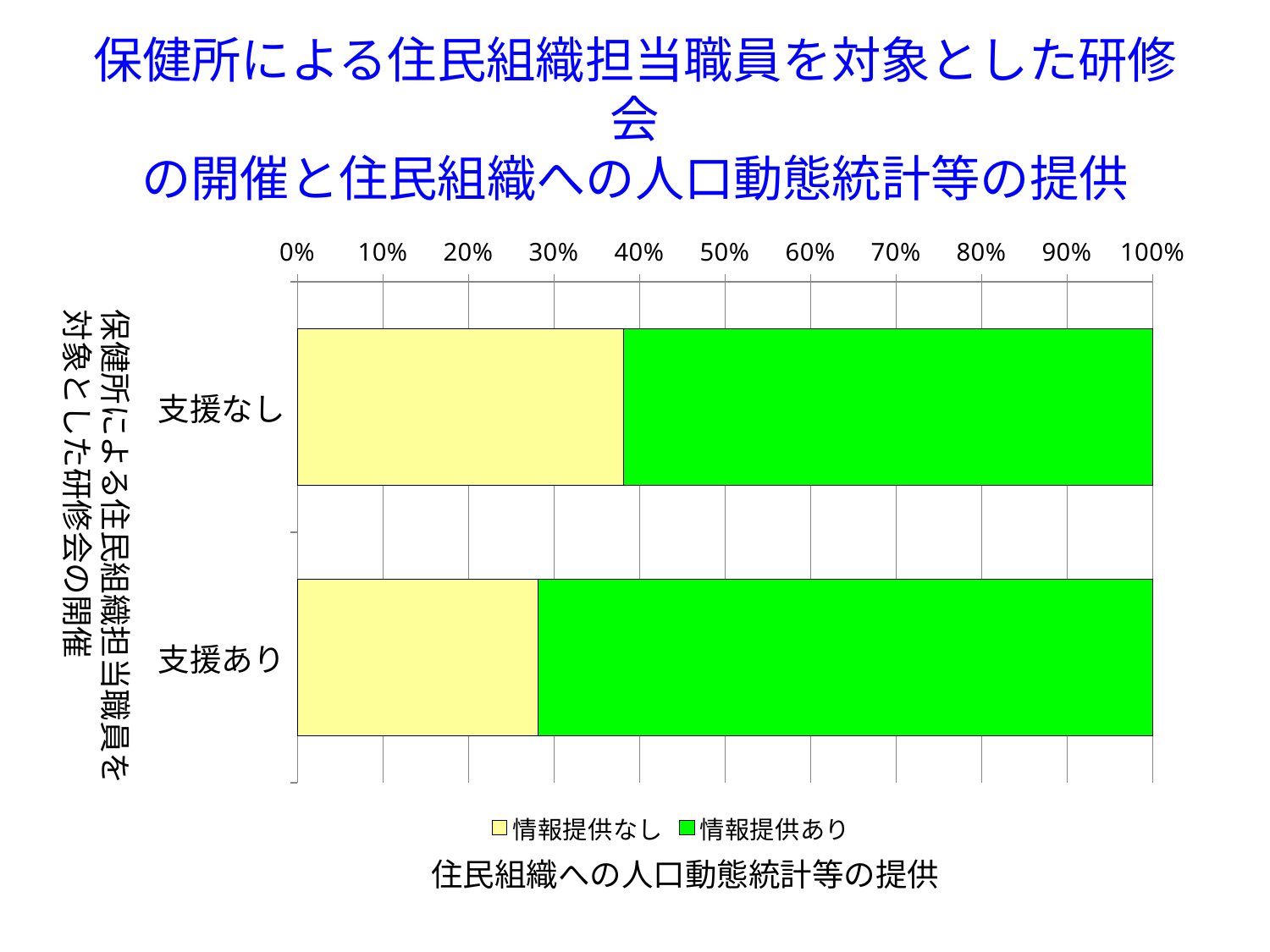
Is the 情報提供なし share for 支援あり greater or less than 20%? greater Which category has the larger 情報提供あり share, 支援なし or 支援あり? 支援あり How many series does the legend list? 2 Which category has the larger 情報提供なし share, 支援なし or 支援あり? 支援なし What kind of chart is shown on the slide? bar chart Which series is shown in green in the chart? 情報提供あり Is the 情報提供なし share for 支援なし greater or less than 40%? less What is the maximum value shown on the horizontal axis of the chart? 100% How many categories are shown on the vertical axis of the chart? 2 Is the 情報提供なし share for 支援あり greater or less than 30%? less Which series is shown in yellow in the chart? 情報提供なし